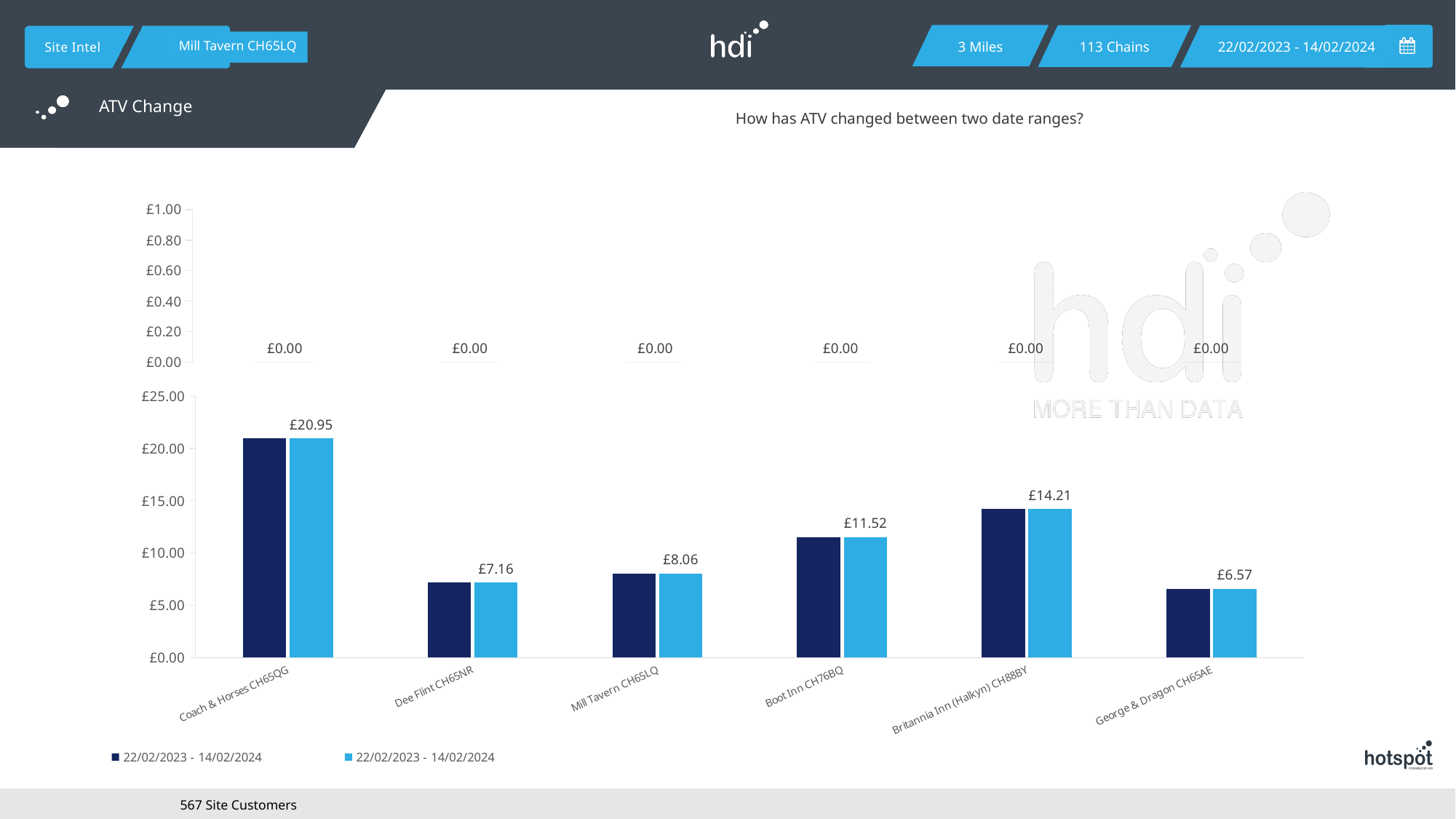
How many sites are shown on the x axis of the bottom bar chart? 6 In the bottom bar chart, what is the difference between the values for Coach & Horses CH65QG and George & Dragon CH65AE? £14.38 How many series does the legend of the bottom chart list? 2 In the bottom bar chart, which has the larger value, Mill Tavern CH65LQ or Dee Flint CH65NR? Mill Tavern CH65LQ In the bottom bar chart, which site has the highest value? Coach & Horses CH65QG What kind of chart is the bottom chart on the slide? bar chart In the bottom bar chart, which site has the lowest value? George & Dragon CH65AE In the bottom bar chart, what is the ATV value shown for Coach & Horses CH65QG? £20.95 In the bottom bar chart, what is the difference between the values for Britannia Inn (Halkyn) CH88BY and Boot Inn CH76BQ? £2.69 In the bottom bar chart, what is the value labelled for Boot Inn CH76BQ? £11.52 In the bottom bar chart, is the value for Britannia Inn (Halkyn) CH88BY greater or less than £10.00? greater